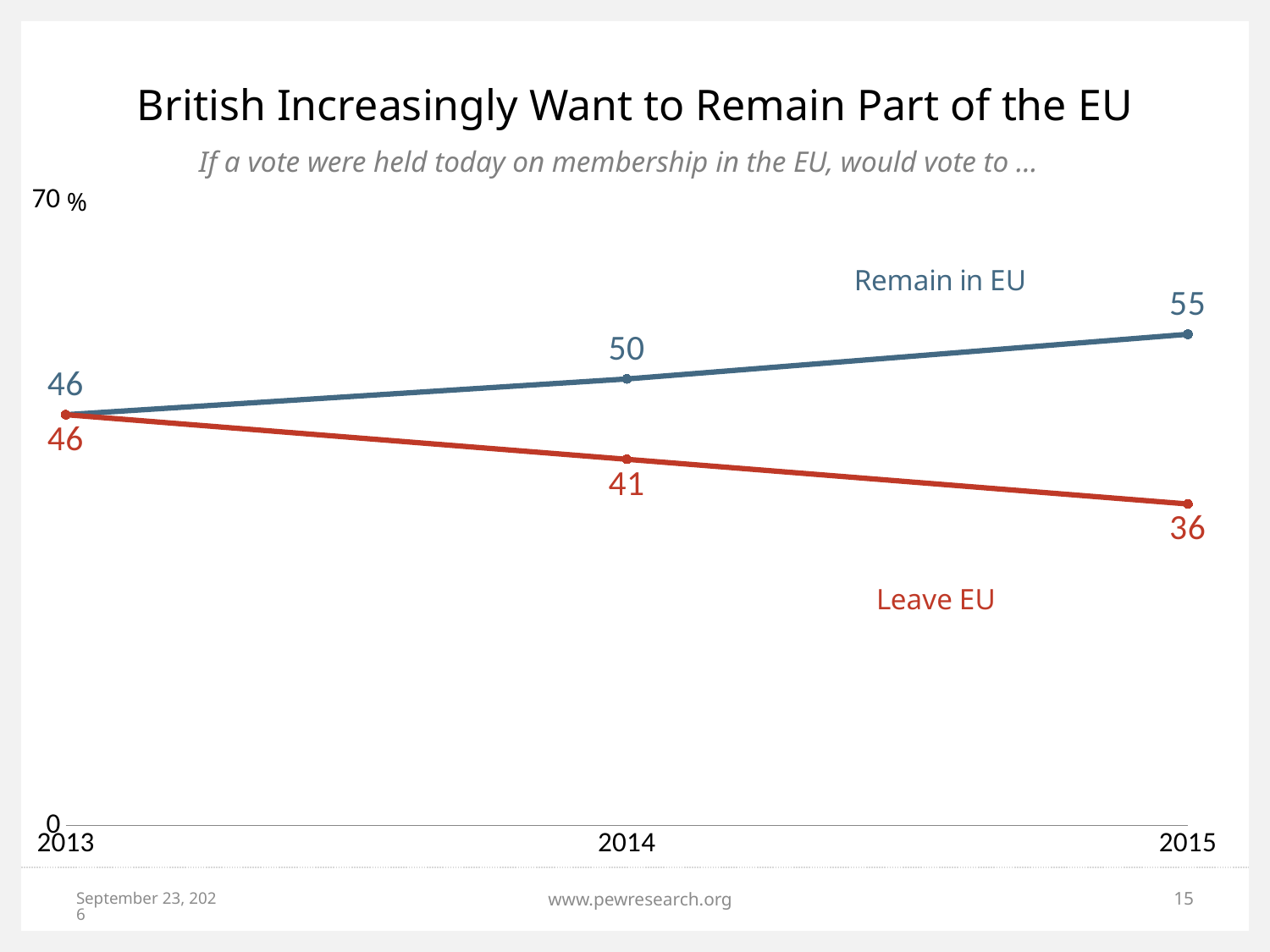
In which year is the Remain in EU value highest? 2015 How many series are shown on the chart? 2 What is the difference between Remain in EU and Leave EU in 2015? 19 What is the value for Leave EU in 2013? 46 What is the title of the chart? British Increasingly Want to Remain Part of the EU Does the Leave EU line rise or fall from 2013 to 2015? Fall In which year is the Leave EU value lowest? 2015 Which is larger in 2014, Remain in EU or Leave EU? Remain in EU How many years are plotted on the x axis? 3 What is the value for Leave EU in 2014? 41 What kind of chart is shown on the slide? Line chart What is the value for Remain in EU in 2015? 55